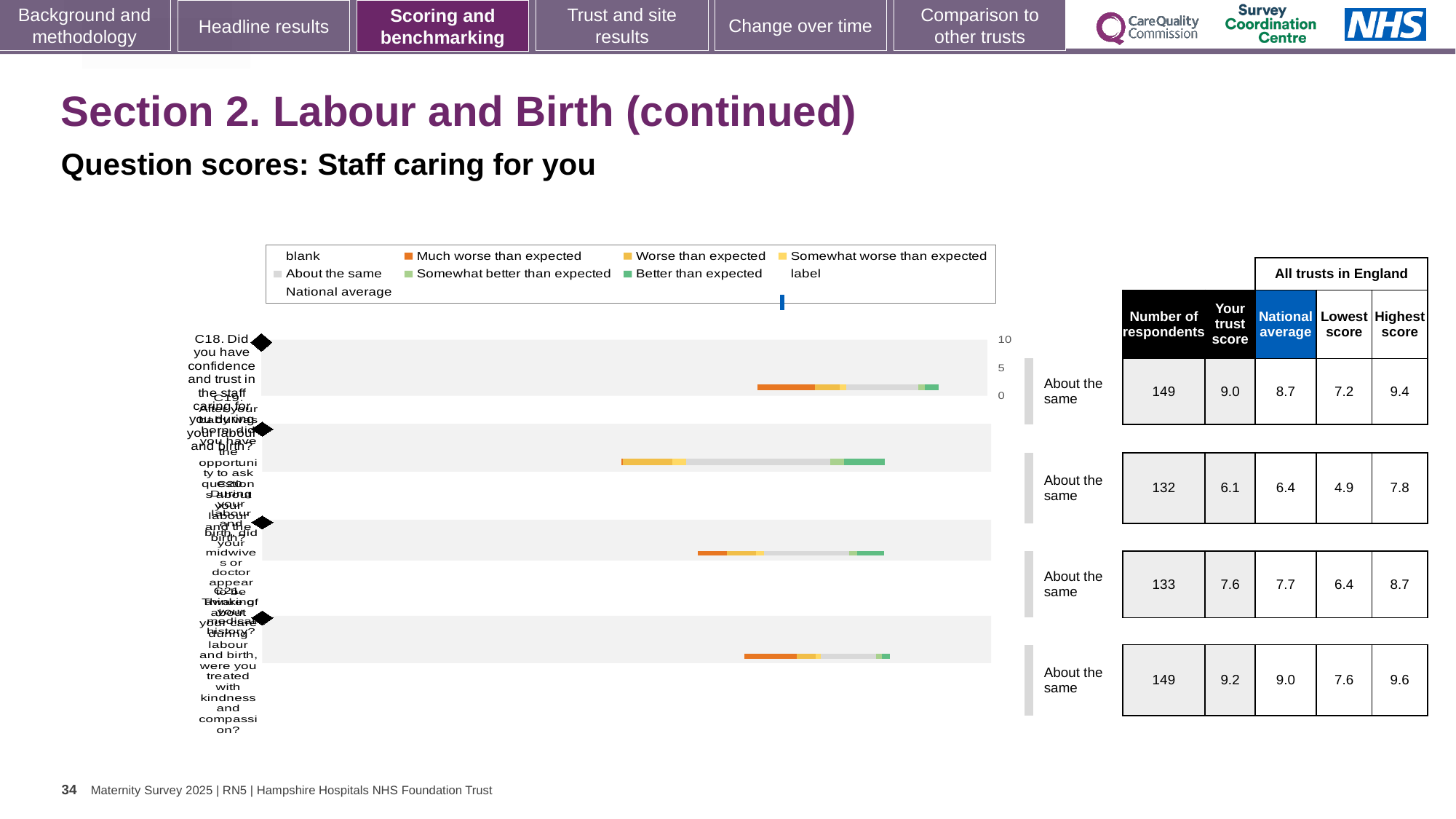
What is the difference between the highest score and the lowest score for the first row (C18)? 2.2 What is the 'Your trust score' value for the first row (C18, confidence and trust in the staff caring for you)? 9.0 Which row has the highest 'Your trust score'? the fourth row (C21), 9.2 What kind of chart is shown on the slide? bar chart Which row has the lowest 'Your trust score'? the second row, 6.1 How many respondents are listed for the second row of the table? 132 By how much does the trust score in the fourth row exceed its national average? 0.2 What colour does the legend use for 'Much worse than expected'? orange What benchmark category is shown for all four questions? About the same For the second row, which is larger: the trust score or the national average? the national average (6.4) How many question bars are plotted in the chart? 4 What is the national average for the first row (C18)? 8.7